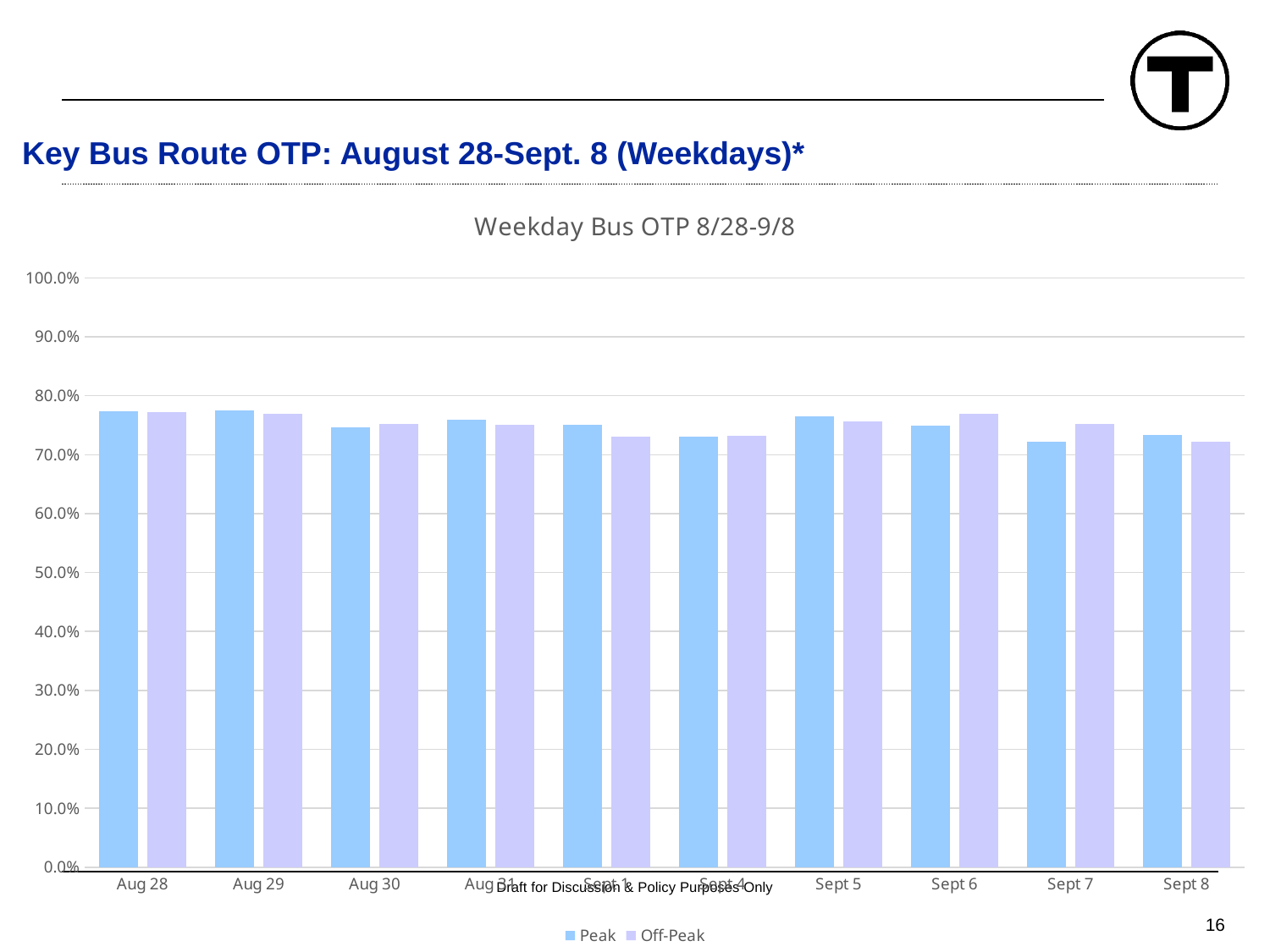
What kind of chart is shown on the slide? Bar chart What is the title of the chart? Weekday Bus OTP 8/28-9/8 How many dates are shown along the x axis? 10 What are the two series named in the legend? Peak and Off-Peak Is the Peak value for Sept 7 greater or less than 70.0%? greater On Sept 6, which is larger, the Peak value or the Off-Peak value? Off-Peak How many series does the legend list? 2 Is the Off-Peak value for Sept 8 greater or less than 80.0%? less Which is larger, the Peak value for Sept 5 or the Peak value for Sept 4? Sept 5 Is the Peak value for Aug 29 greater or less than 80.0%? less On Sept 7, which is larger, the Peak value or the Off-Peak value? Off-Peak